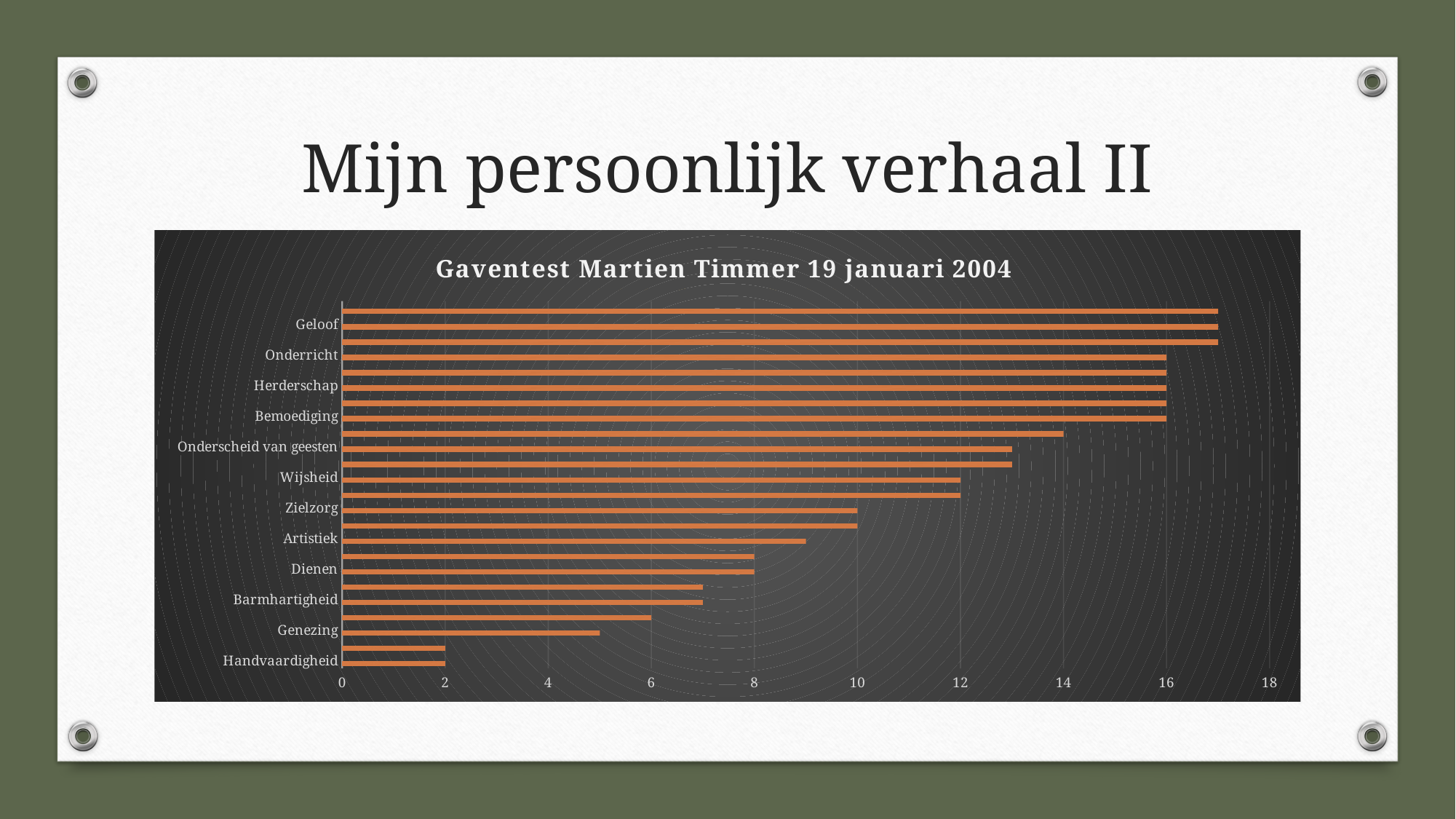
What is the value for Dienen? 8 What is the value for Handvaardigheid? 2 What is the title of the chart? Gaventest Martien Timmer 19 januari 2004 What kind of chart is shown on the slide? bar chart What is the value for Wijsheid? 12 Is the value for Geloof greater or less than 16? greater What is the value for Zielzorg? 10 Which is larger, the value for Zielzorg or the value for Dienen? Zielzorg What is the difference between the values for Wijsheid and Dienen? 4 Is the value for Barmhartigheid greater or less than 8? less